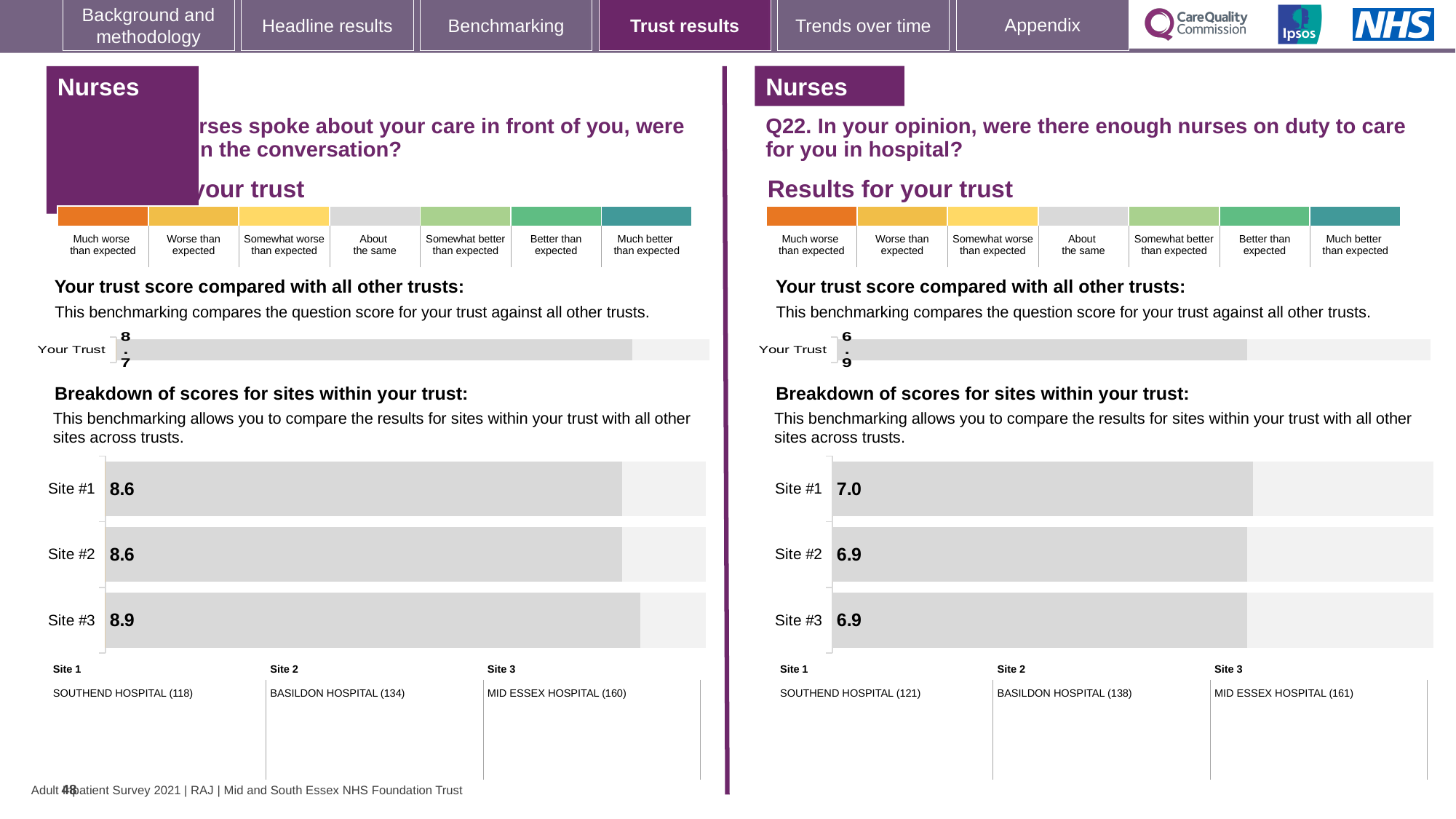
What type of chart is used for the site breakdown on the left-hand side of the slide? Bar chart In the left-hand site breakdown chart, what is the score for Site #3? 8.9 In the right-hand site breakdown chart (Q22), what is the score for Site #1? 7.0 Is the Site #1 score in the left-hand site breakdown chart larger or smaller than the Site #1 score in the right-hand (Q22) site breakdown chart? Larger In the right-hand site breakdown chart (Q22), which site has the highest score? Site #1 In the left-hand site breakdown chart, what is the score for Site #1? 8.6 In the left-hand site breakdown chart, what is the difference between the scores for Site #3 and Site #2? 0.3 In the left-hand 'Your trust score compared with all other trusts' chart, what is the score for Your Trust? 8.7 In the right-hand site breakdown chart (Q22), what is the score for Site #2? 6.9 In the left-hand site breakdown chart, which site has the highest score? Site #3 In the right-hand 'Your trust score compared with all other trusts' chart (Q22), what is the score for Your Trust? 6.9 How many sites are shown in the right-hand site breakdown chart (Q22)? 3